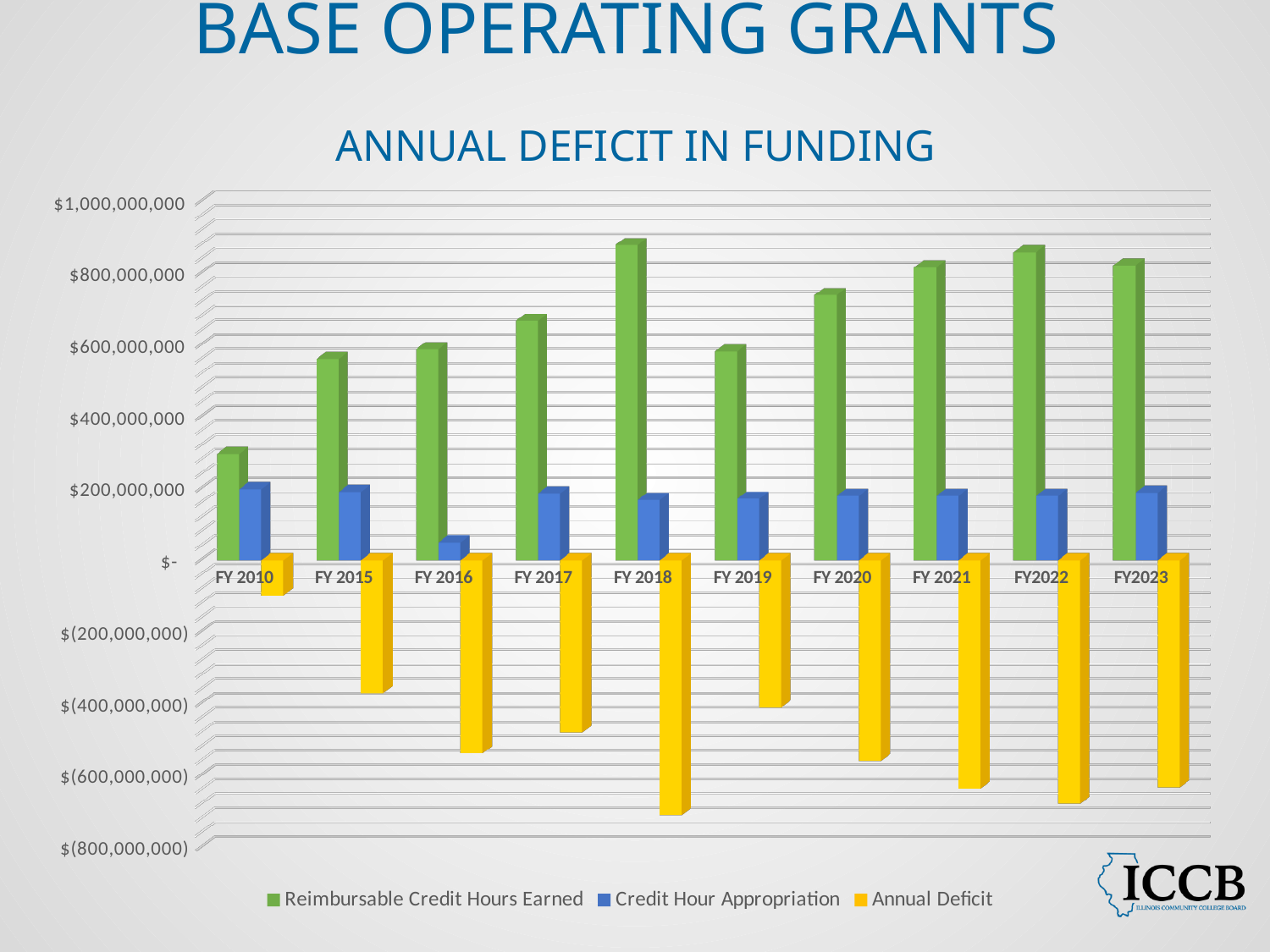
Is the value for Reimbursable Credit Hours Earned in FY 2010 greater or less than $400,000,000? less Is the value for Reimbursable Credit Hours Earned in FY 2018 greater or less than $800,000,000? greater How many fiscal years are shown on the x axis of the chart? 10 Which is larger, Reimbursable Credit Hours Earned in FY 2017 or in FY 2019? FY 2017 Which fiscal year has the lowest value for Reimbursable Credit Hours Earned? FY 2010 What type of chart is shown on the slide? Bar chart Which fiscal year has the lowest Credit Hour Appropriation? FY 2016 How many series does the chart's legend list? 3 Which fiscal year has the highest value for Reimbursable Credit Hours Earned? FY 2018 What is the title of the chart? ANNUAL DEFICIT IN FUNDING Which fiscal year has the smallest Annual Deficit (the shortest yellow bar)? FY 2010 Is the Credit Hour Appropriation for FY 2016 greater or less than $200,000,000? less